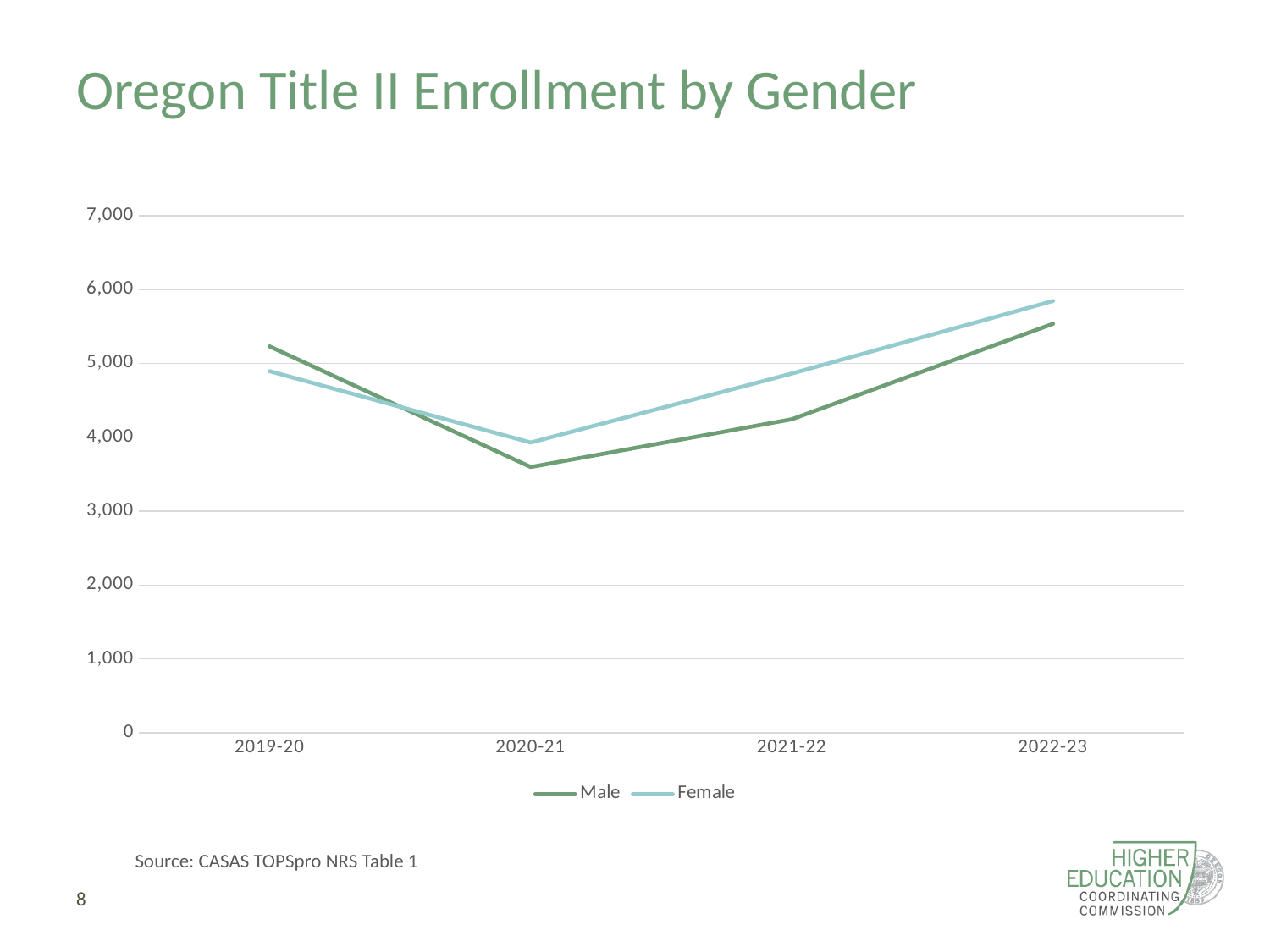
How many series does the legend list? 2 Is the Male value for 2020-21 greater or less than 4,000? less Is the Female value for 2022-23 greater or less than 6,000? less In which year is Female enrollment highest? 2022-23 In 2019-20, which is larger, Male or Female enrollment? Male Is the Male value for 2019-20 greater or less than 5,000? greater In which year is Male enrollment lowest? 2020-21 What is the title of the chart? Oregon Title II Enrollment by Gender Does Male enrollment rise or fall from 2020-21 to 2022-23? Rise How many years are plotted along the x axis? 4 In 2022-23, which is larger, Male or Female enrollment? Female What kind of chart is shown on the slide? Line chart